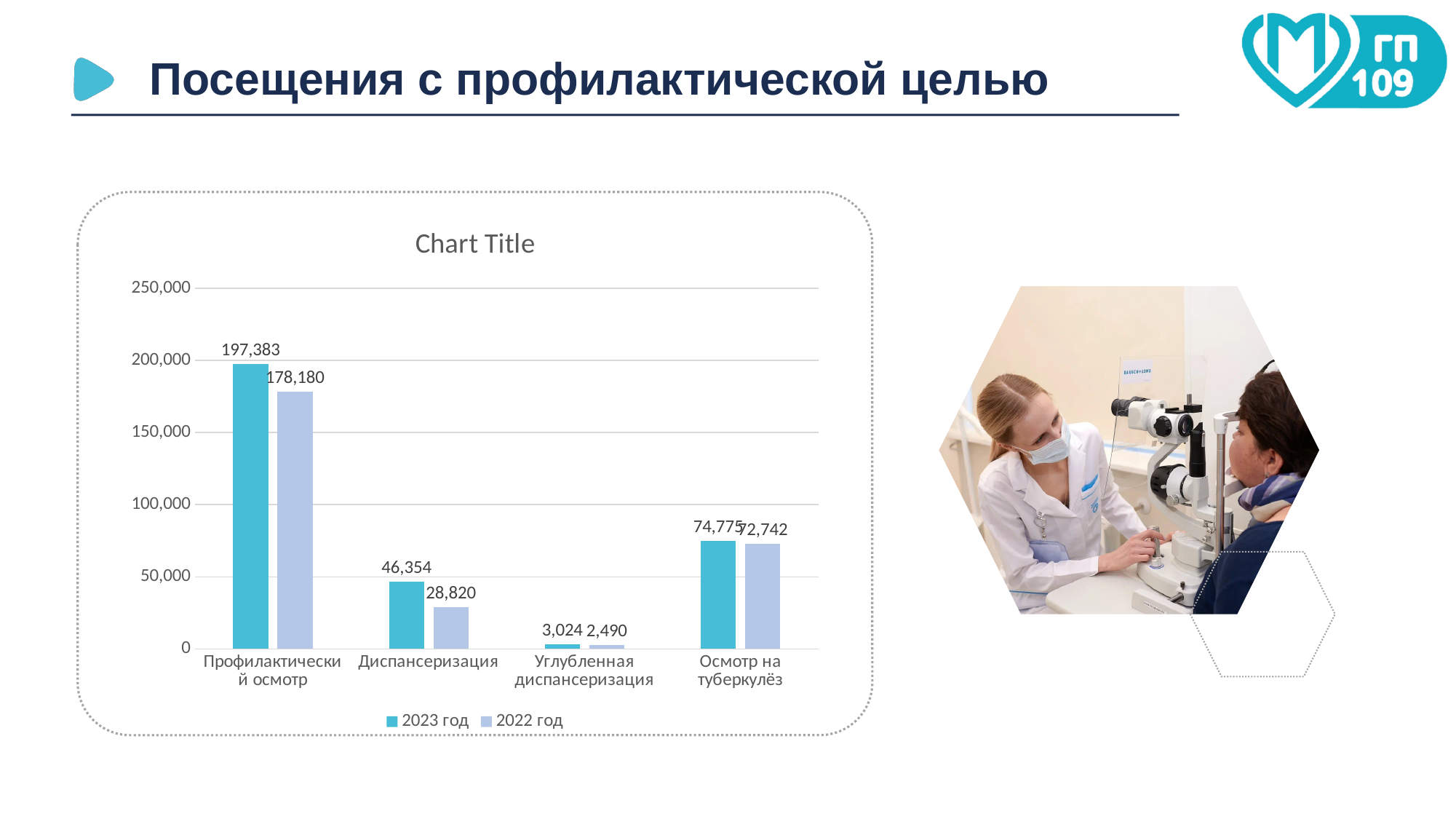
What is the value for Диспансеризация in the 2022 год series? 28,820 Which category has the lowest value in the 2022 год series? Углубленная диспансеризация Which category has the highest value in the 2023 год series? Профилактический осмотр What is the value for Осмотр на туберкулёз in the 2022 год series? 72,742 What type of chart is shown on the slide? Bar chart Which is larger for Профилактический осмотр: the 2023 год value or the 2022 год value? 2023 год How many series does the legend list? 2 What is the value for Углубленная диспансеризация in the 2023 год series? 3,024 What is the difference between the 2023 год and 2022 год values for Диспансеризация? 17,534 What is the title shown above the chart? Chart Title How many categories are shown on the x axis? 4 What is the value for Профилактический осмотр in the 2023 год series? 197,383